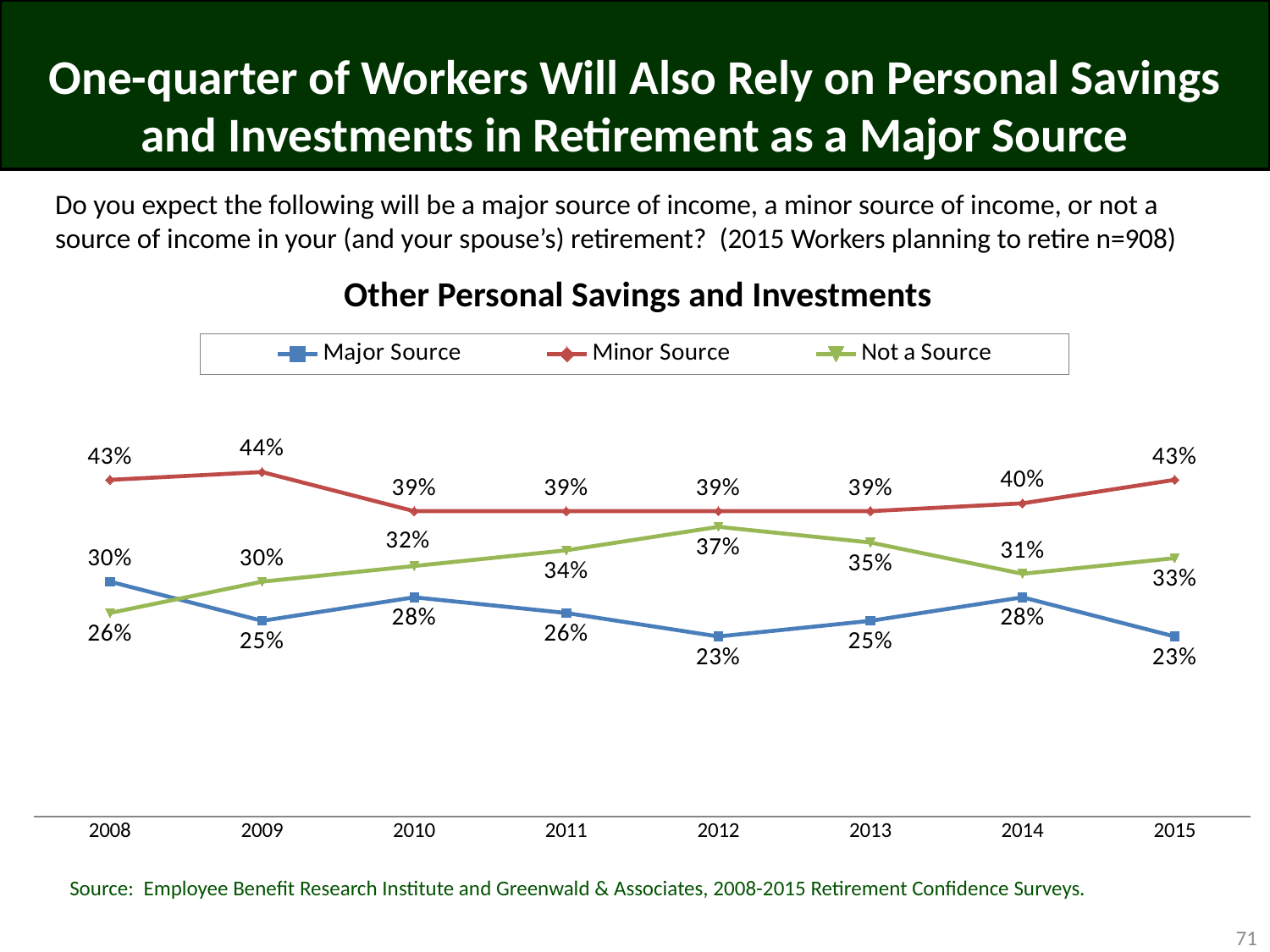
What is the title of the chart? Other Personal Savings and Investments In which year is the Major Source value highest? 2008 What kind of chart is shown on the slide? Line chart What is the value for Minor Source in 2009? 44% What is the value for Not a Source in 2012? 37% How many years are shown on the x axis? 8 Does the Not a Source value rise or fall from 2008 to 2012? Rise What is the difference between the Minor Source and Major Source values in 2015? 20 percentage points How many series does the legend list? 3 In which year is the Not a Source value highest? 2012 Which is larger in 2008, the Major Source value or the Not a Source value? Major Source What is the value for Major Source in 2015? 23%